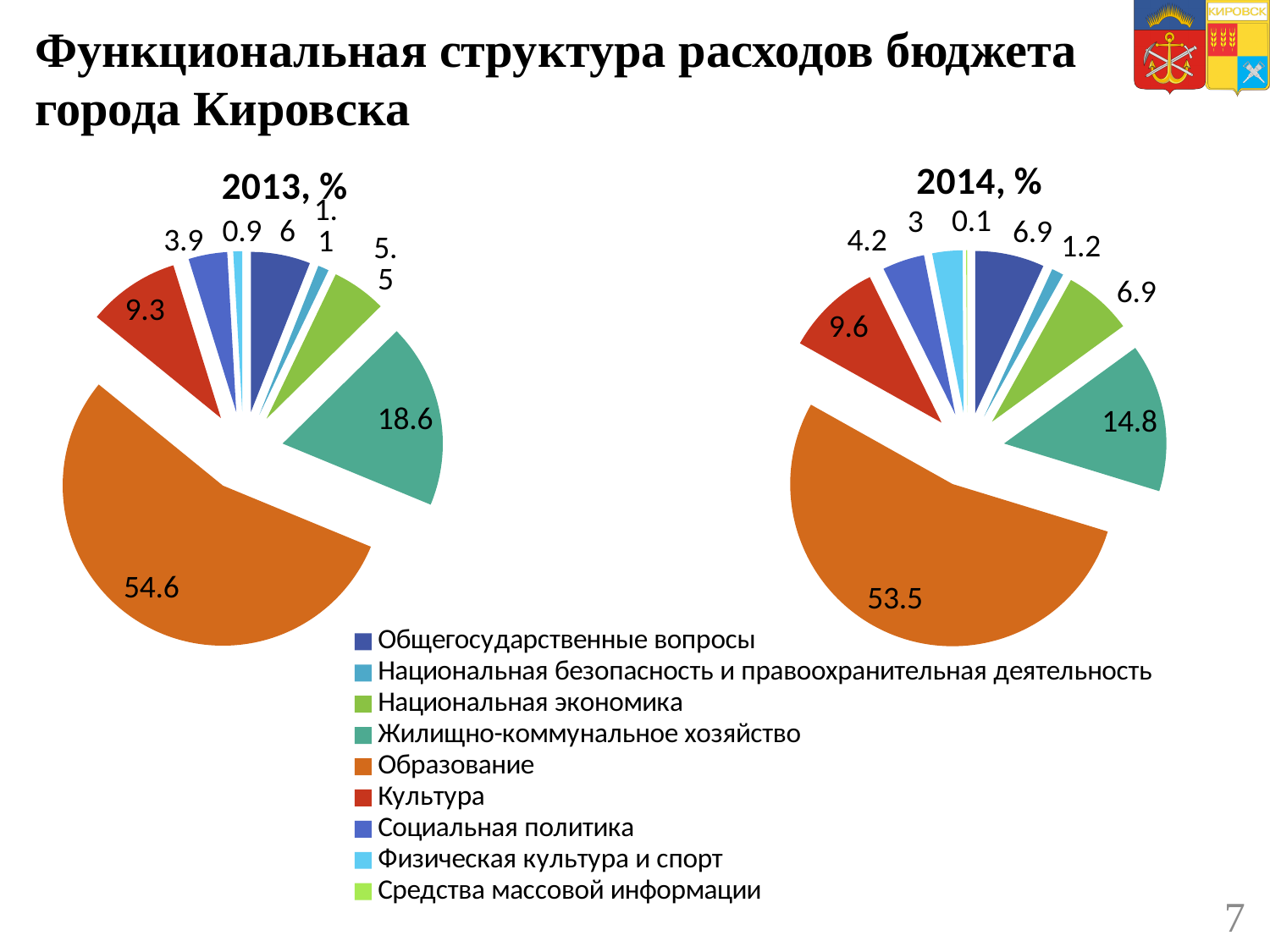
In the 2014 pie chart, what is the value for Культура? 9.6 In the 2013 pie chart, which category has the largest share? Образование Is the share of Жилищно-коммунальное хозяйство larger in the 2013 chart or the 2014 chart? 2013 In the 2013 pie chart, what is the value for Образование? 54.6 In the 2014 pie chart, what is the value for Социальная политика? 4.2 By how much did the share of Образование change from the 2013 chart to the 2014 chart? 1.1 In the 2014 pie chart, which category has the smallest share? Средства массовой информации In the 2013 pie chart, what is the value for Жилищно-коммунальное хозяйство? 18.6 What type of chart is used on this slide? Pie chart How many categories does the legend list? 9 In the 2014 pie chart, what is the value for Жилищно-коммунальное хозяйство? 14.8 In the 2014 pie chart, what is the value for Образование? 53.5